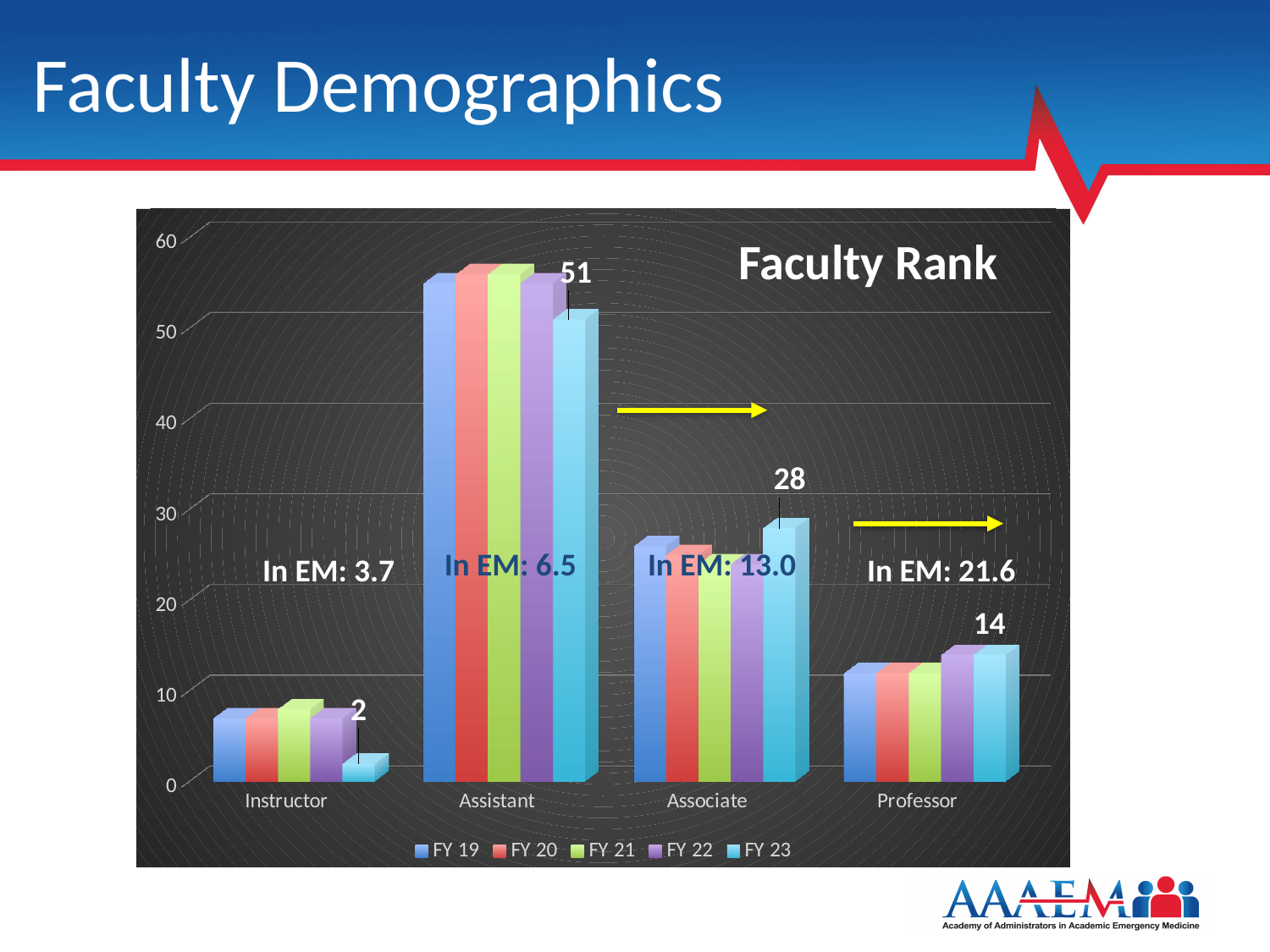
How many faculty rank categories are shown on the x axis? 4 What is the FY 23 value for Instructor? 2 What is the FY 23 value for Assistant? 51 What is the title of the chart? Faculty Rank Which faculty rank has the highest FY 23 value? Assistant What kind of chart is shown on the slide? bar chart Is the FY 19 value for Assistant greater or less than 50? greater What is the FY 23 value for Professor? 14 What is the difference between the FY 23 values for Assistant and Associate? 23 How many series does the legend of the Faculty Rank chart list? 5 What is the FY 23 value for Associate? 28 Which faculty rank has the lowest FY 23 value? Instructor